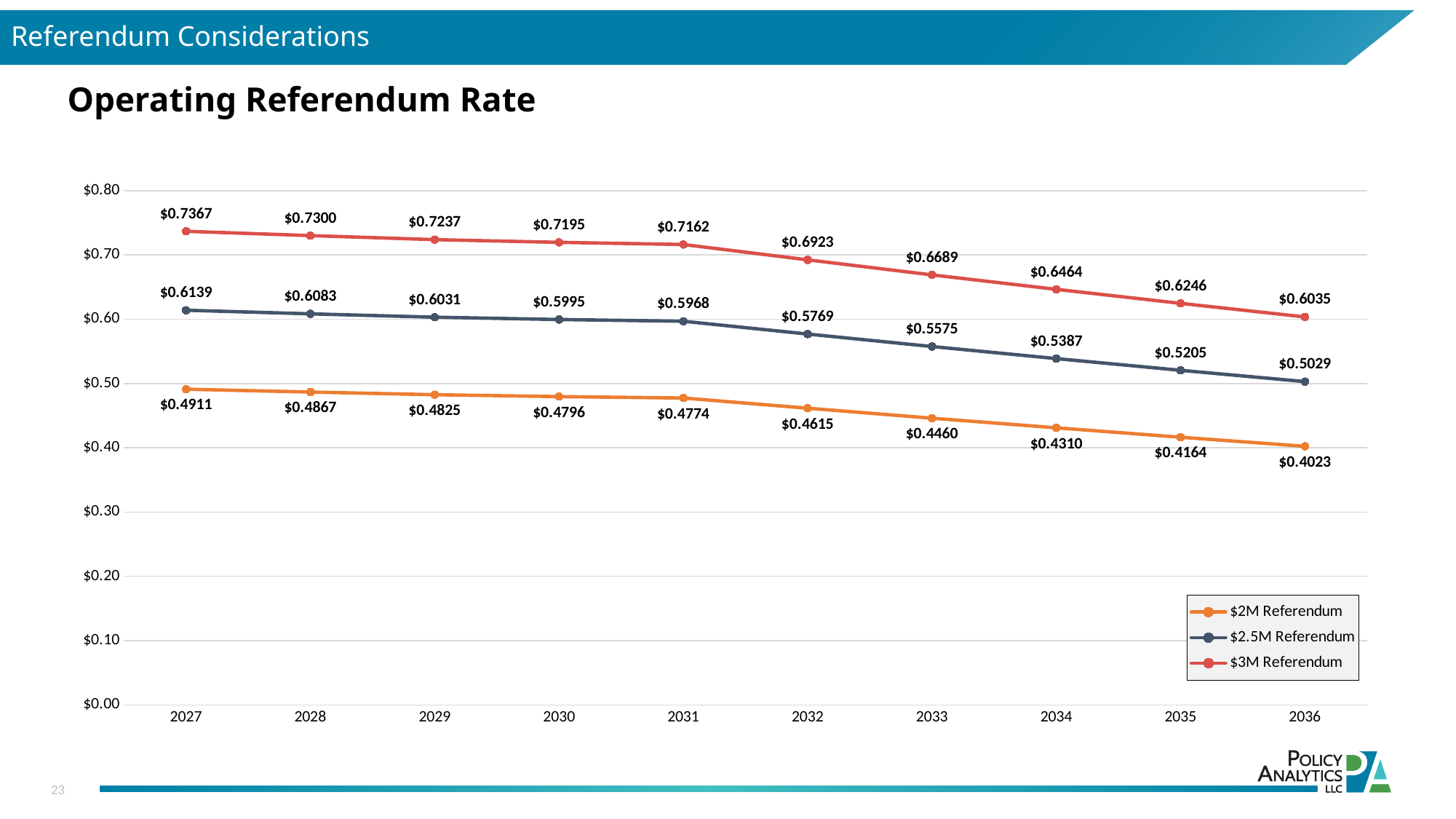
What is the difference between the $3M Referendum rate and the $2M Referendum rate in 2031? $0.2388 What is the $2M Referendum rate in 2036? $0.4023 How many series does the legend list? 3 What is the title of the chart? Operating Referendum Rate What kind of chart is shown on the slide? Line chart Which year has the highest $3M Referendum rate? 2027 What is the $2.5M Referendum rate in 2032? $0.5769 How many years are shown on the x axis? 10 What is the $3M Referendum rate in 2027? $0.7367 Do the $2M Referendum rates rise or fall from 2027 to 2036? Fall Which is larger in 2034: the $2.5M Referendum rate or the $2M Referendum rate? $2.5M Referendum Which year has the lowest $2.5M Referendum rate? 2036